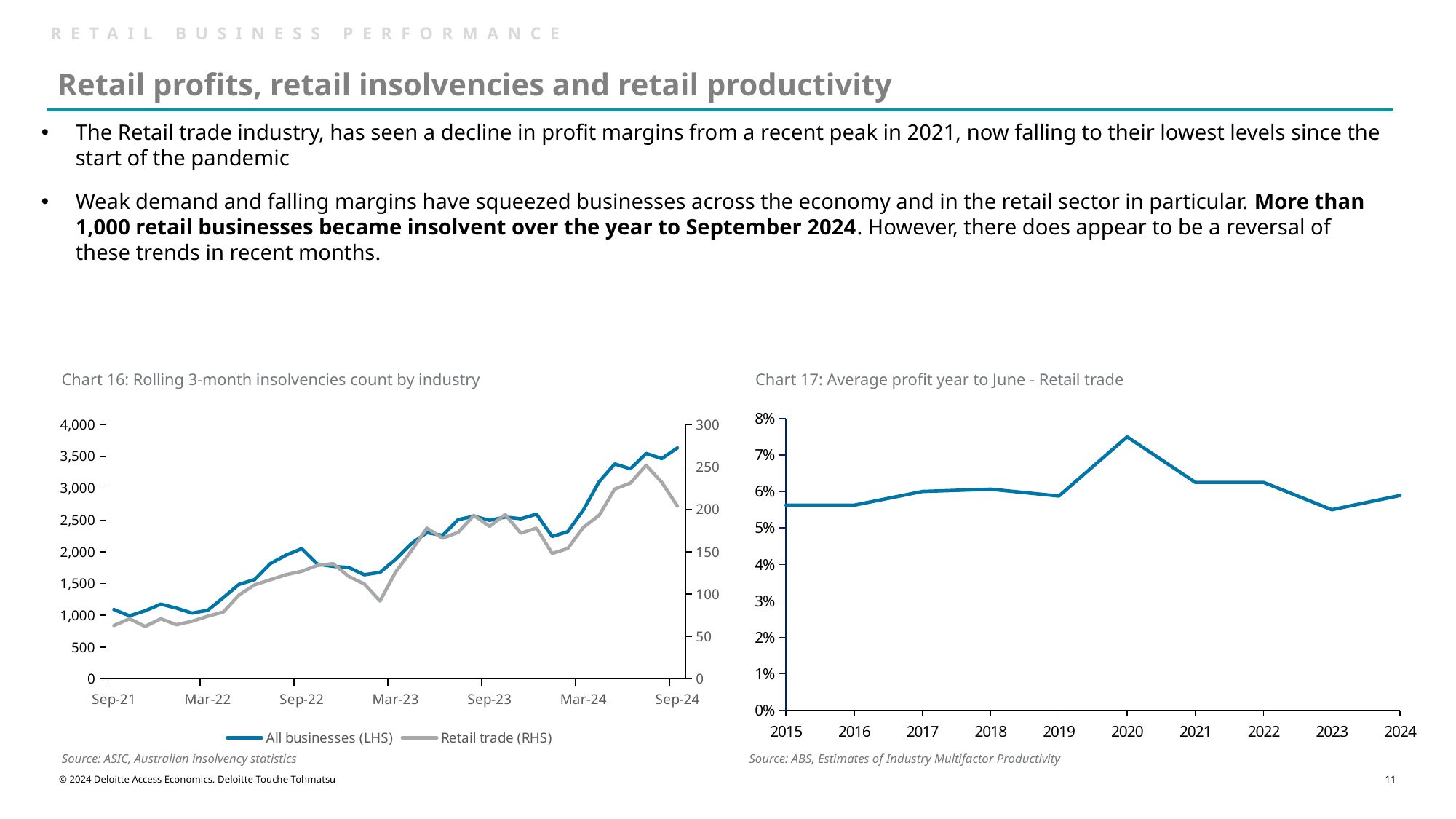
In Chart 17, do the values rise or fall from 2020 to 2023? fall What kind of chart is Chart 16: Rolling 3-month insolvencies count by industry? line chart In Chart 17, is the value for 2020 greater or less than 7%? greater In Chart 17, is the value for 2023 greater or less than 6%? less In Chart 17, which year has the highest average profit? 2020 In Chart 16, is the value for All businesses (LHS) at Sep-24 greater or less than 3,500? greater How many series does the legend of Chart 16 list? 2 How many years are plotted in Chart 17? 10 In Chart 16, do the All businesses (LHS) values overall rise or fall from Sep-21 to Sep-24? rise What kind of chart is Chart 17: Average profit year to June - Retail trade? line chart